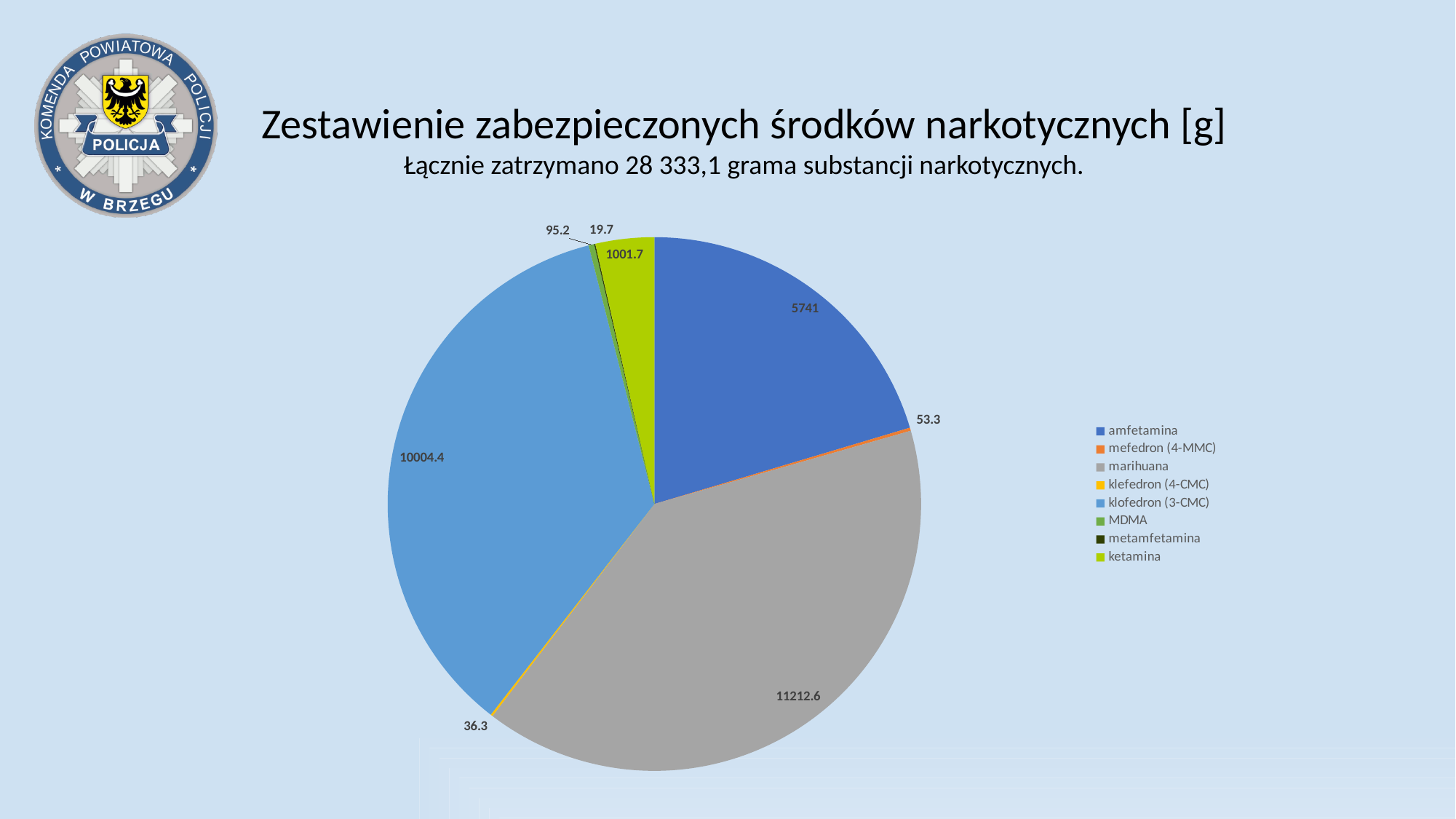
Which is larger, the value for amfetamina or the value for ketamina? amfetamina What value is shown for klofedron (3-CMC)? 10004.4 What value is shown for ketamina? 1001.7 What kind of chart is shown on the slide? pie chart What is the difference between the values for marihuana and klofedron (3-CMC)? 1208.2 What value is shown for marihuana on the pie chart? 11212.6 How many substances are shown in the pie chart? 8 What value is shown for amfetamina? 5741 Which substance has the largest slice of the pie? marihuana Which substance has the smallest value on the chart? metamfetamina What value is shown for MDMA? 95.2 What is the difference between the values for MDMA and metamfetamina? 75.5